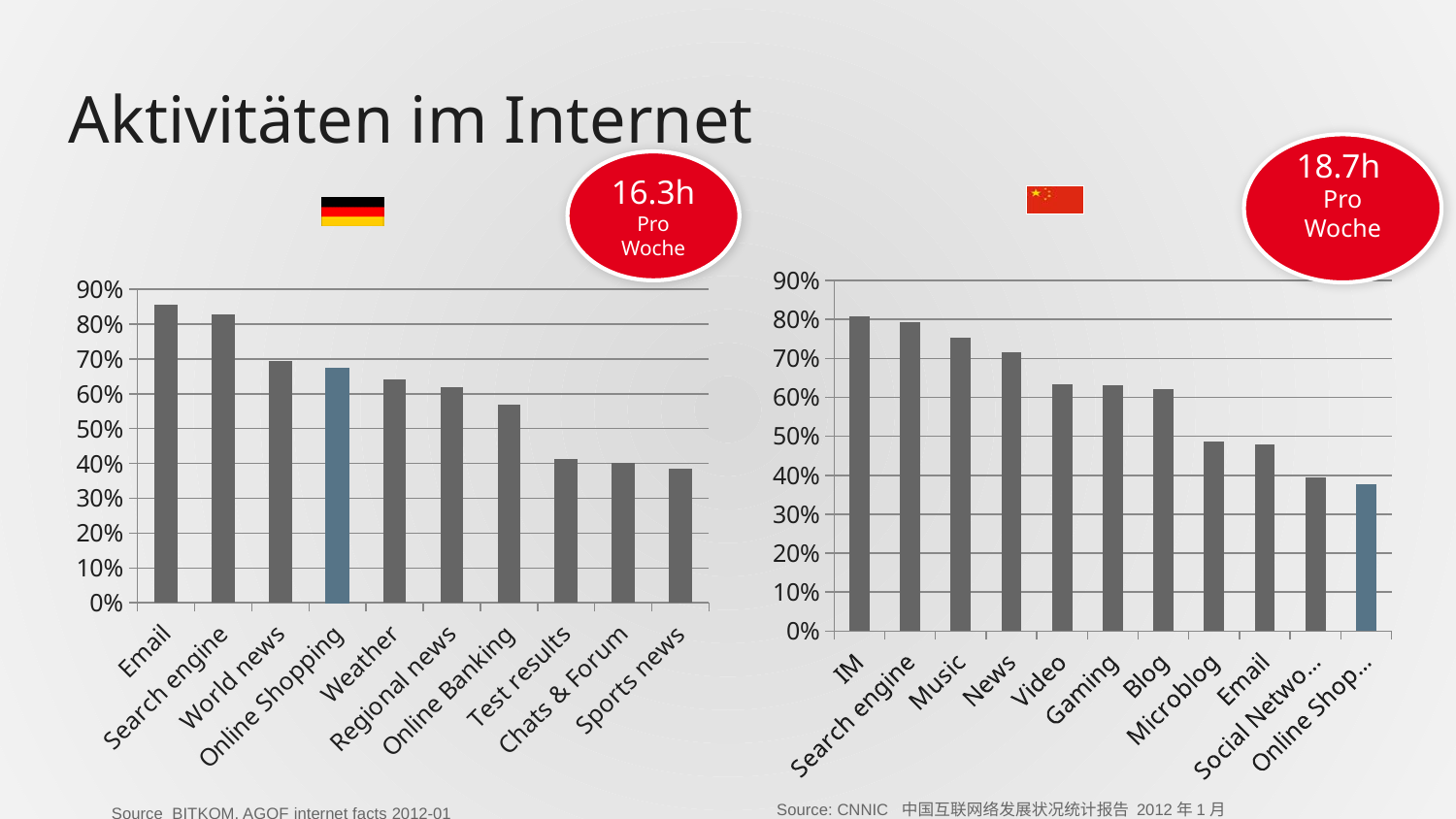
How many categories are shown on the right chart (China)? 11 On the left chart (Germany), which category's bar is highlighted in blue? Online Shopping On the left chart (Germany), is the value for Email greater or less than 80%? greater On the left chart (Germany), which is larger, World news or Weather? World news How many categories are shown on the left chart (Germany)? 10 On the left chart (Germany), which category has the highest value? Email On the right chart (China), do the values rise or fall from left to right along the x axis? fall On the left chart (Germany), is the value for Online Banking greater or less than 60%? less What kind of chart is the left chart (Germany)? bar chart On the right chart (China), is the value for Music greater or less than 70%? greater On the right chart (China), which is larger, Music or Blog? Music